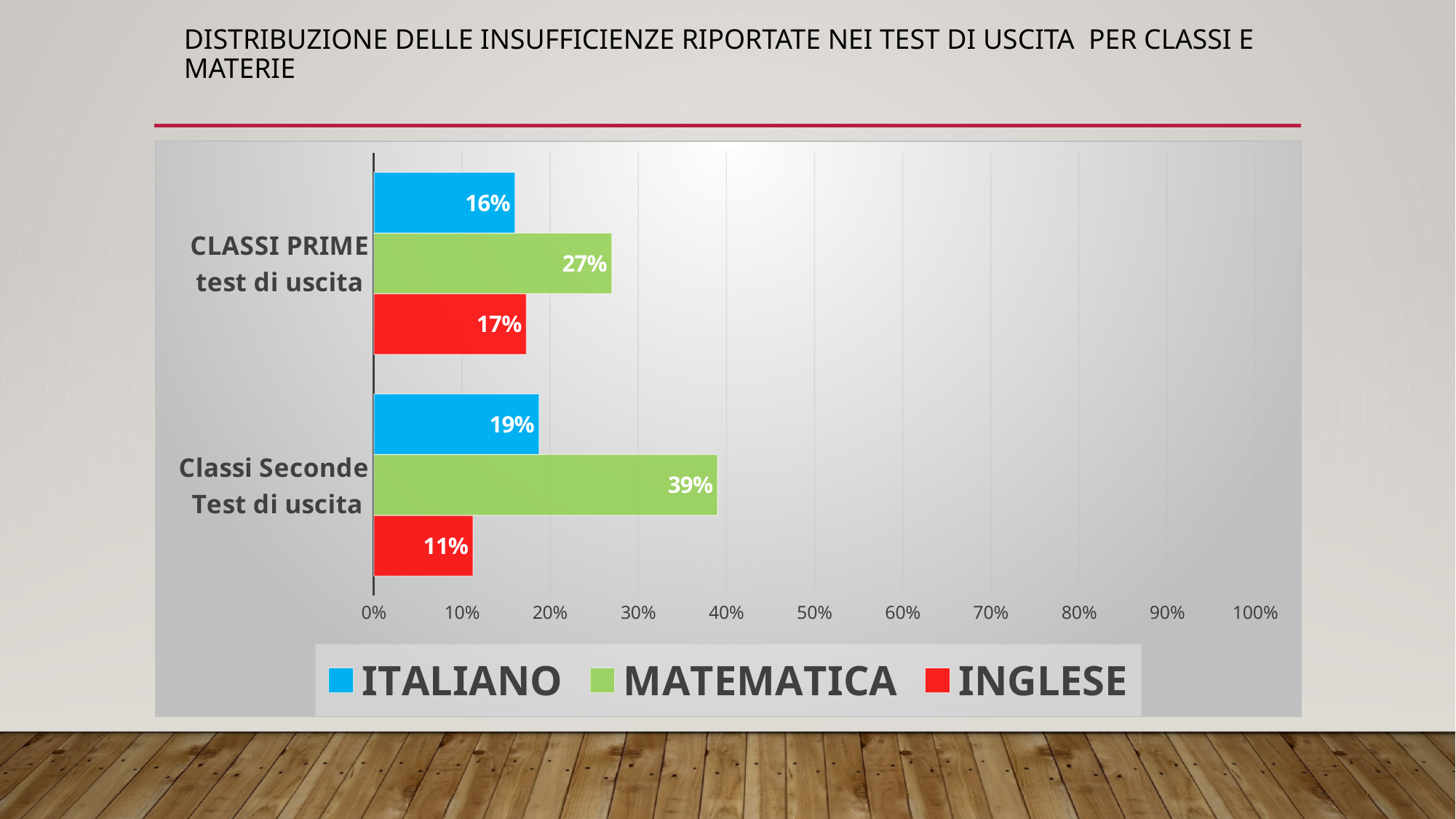
How many series does the legend list? 3 What is the value for INGLESE in Classi Seconde Test di uscita? 11% Which subject has the lowest value in CLASSI PRIME test di uscita? ITALIANO Which is larger: INGLESE in CLASSI PRIME or INGLESE in Classi Seconde? INGLESE in CLASSI PRIME How many class groups are shown on the chart? 2 What is the value for MATEMATICA in CLASSI PRIME test di uscita? 27% What kind of chart is shown on the slide? Bar chart What is the value for ITALIANO in Classi Seconde Test di uscita? 19% Which subject has the highest value in Classi Seconde Test di uscita? MATEMATICA What is the difference between the MATEMATICA values for Classi Seconde and CLASSI PRIME? 12% Is the value for MATEMATICA in Classi Seconde greater or less than 30%? greater Which colour represents INGLESE in the legend? Red